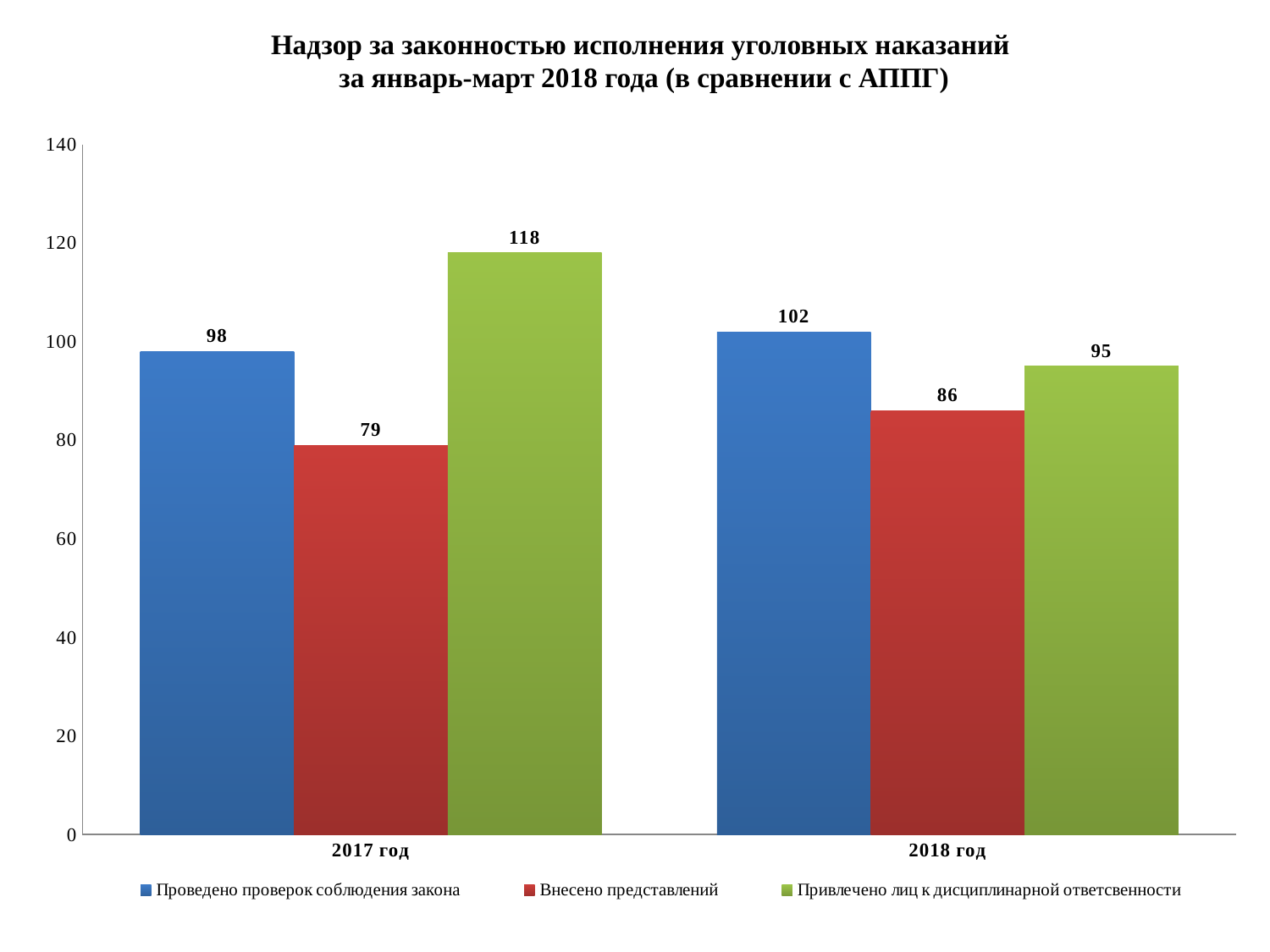
What is the value of 'Внесено представлений' for 2018 год? 86 What is the difference between 'Привлечено лиц к дисциплинарной ответсвенности' in 2017 год and 2018 год? 23 Which series has the lowest value in 2018 год? Внесено представлений What kind of chart is shown on the slide? Bar chart What is the value of 'Проведено проверок соблюдения закона' for 2017 год? 98 What is the value of 'Привлечено лиц к дисциплинарной ответсвенности' for 2017 год? 118 Which series has the highest value in 2017 год? Привлечено лиц к дисциплинарной ответсвенности How many series does the legend list? 3 What colour represents 'Внесено представлений' in the chart? Red How many categories are shown on the x axis? 2 Which is larger: 'Проведено проверок соблюдения закона' in 2017 год or in 2018 год? 2018 год Does the value of 'Внесено представлений' rise or fall from 2017 год to 2018 год? Rise